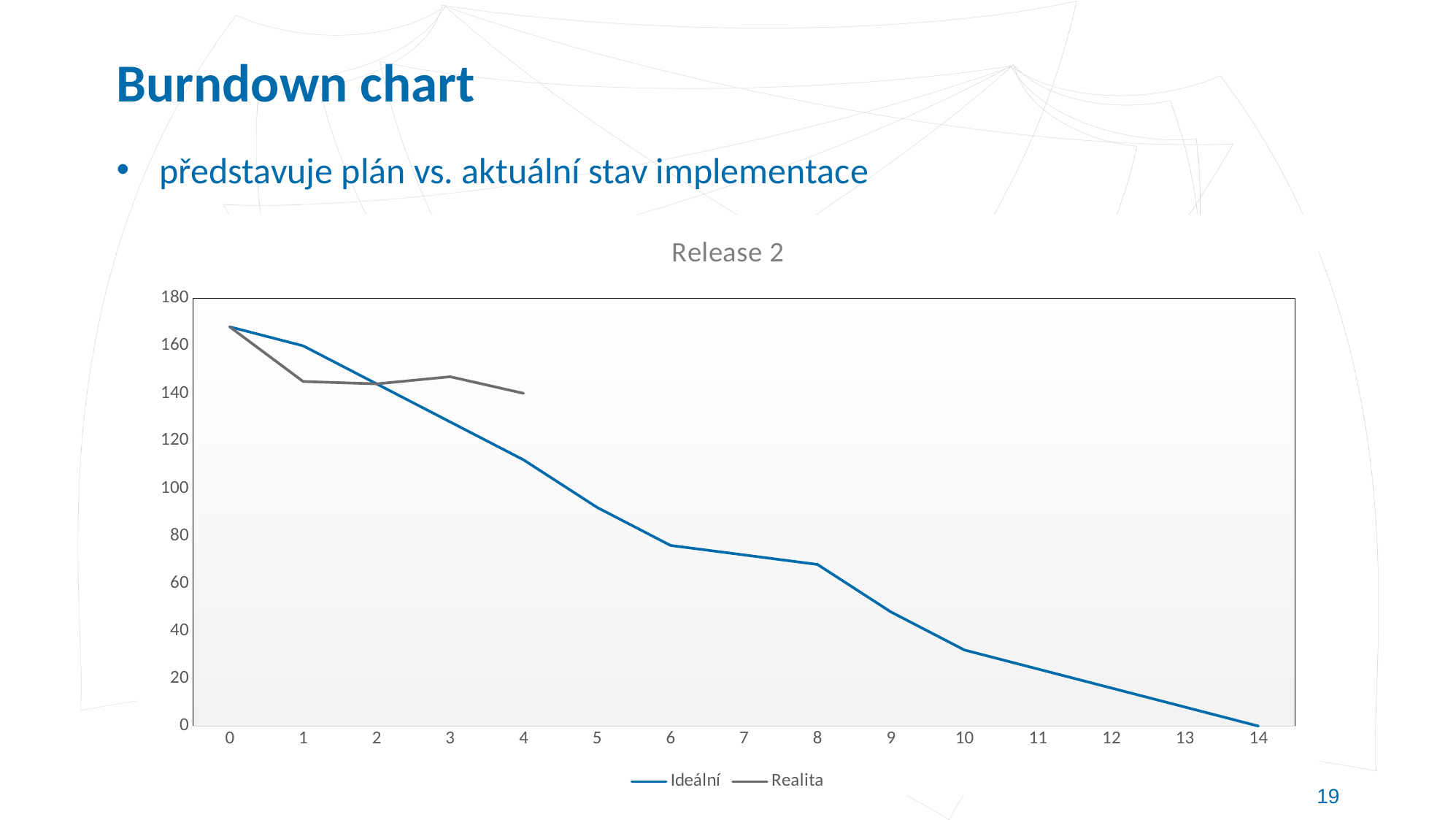
How many points are labelled on the x axis? 15 Is the value of the Ideální series at x = 10 greater or less than 20? greater How many series does the legend list? 2 What kind of chart is shown on the slide? line chart What is the title of the chart? Release 2 At x = 3, which series has the larger value, Ideální or Realita? Realita Which series is drawn in blue? Ideální What is the value of the Ideální series at x = 14? 0 Is the value of the Ideální series at x = 5 greater or less than 100? less At x = 1, which series has the larger value, Ideální or Realita? Ideální Is the value of the Ideální series at x = 6 greater or less than 80? less Does the Ideální series rise or fall along the x axis? fall